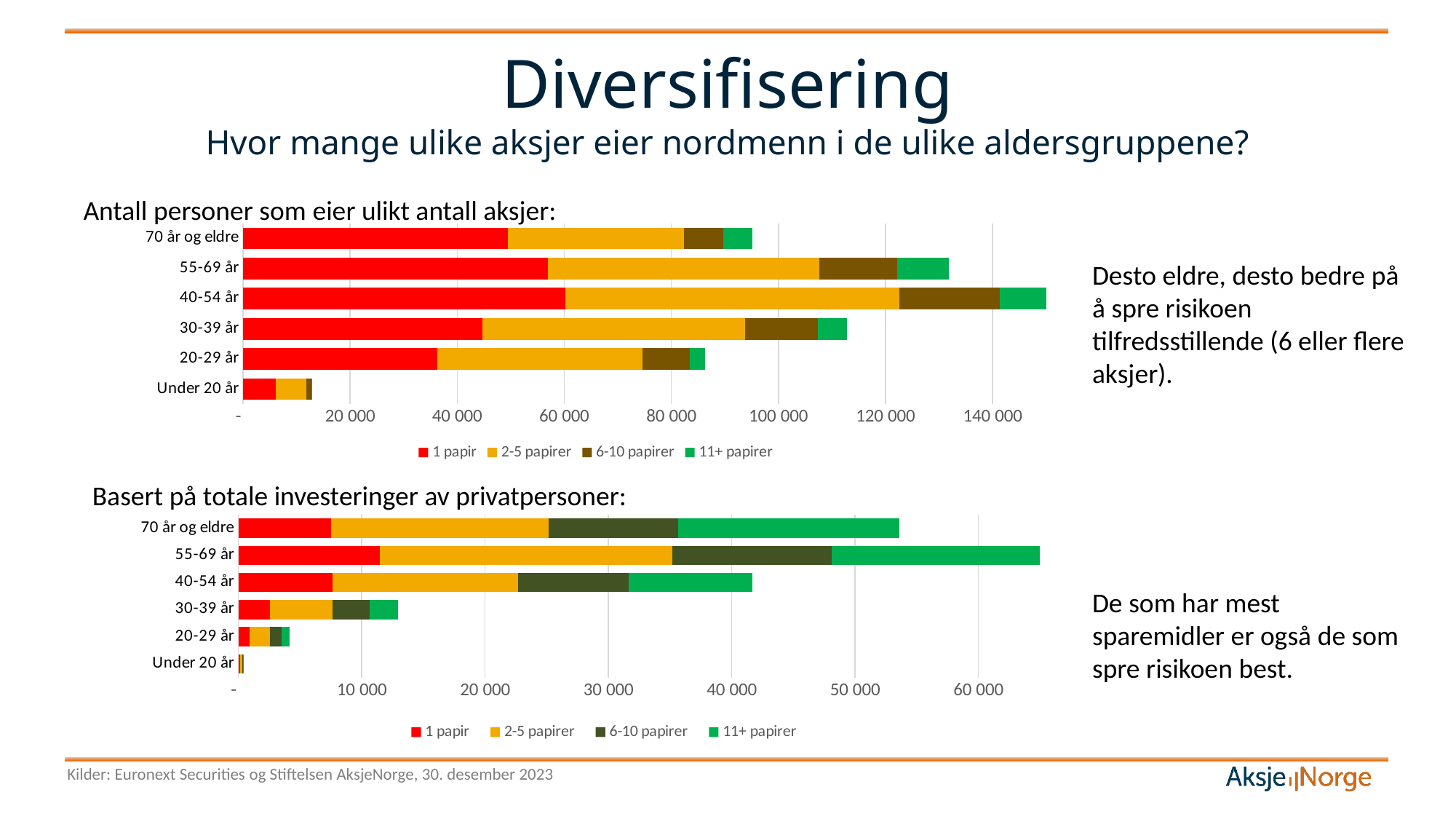
In the bottom chart, 'Basert på totale investeringer av privatpersoner', which age group has the longest total bar? 55-69 år In the top chart, 'Antall personer som eier ulikt antall aksjer', which age group has the shortest total bar? Under 20 år In the bottom chart, 'Basert på totale investeringer av privatpersoner', which colour represents the '11+ papirer' series? Green In the bottom chart, 'Basert på totale investeringer av privatpersoner', which total bar is longer: 70 år og eldre or 40-54 år? 70 år og eldre In the top chart, 'Antall personer som eier ulikt antall aksjer', which total bar is longer: 30-39 år or 20-29 år? 30-39 år In the top chart, 'Antall personer som eier ulikt antall aksjer', is the total bar for 40-54 år greater or less than 140 000? greater How many series does the legend of the bottom chart, 'Basert på totale investeringer av privatpersoner', list? 4 In the top chart, 'Antall personer som eier ulikt antall aksjer', is the total bar for 20-29 år greater or less than 100 000? less How many age groups are shown in the top chart, 'Antall personer som eier ulikt antall aksjer'? 6 What kind of chart is the top chart, 'Antall personer som eier ulikt antall aksjer'? Stacked bar chart In the bottom chart, 'Basert på totale investeringer av privatpersoner', is the total bar for 55-69 år greater or less than 60 000? greater In the top chart, 'Antall personer som eier ulikt antall aksjer', which age group has the longest total bar? 40-54 år